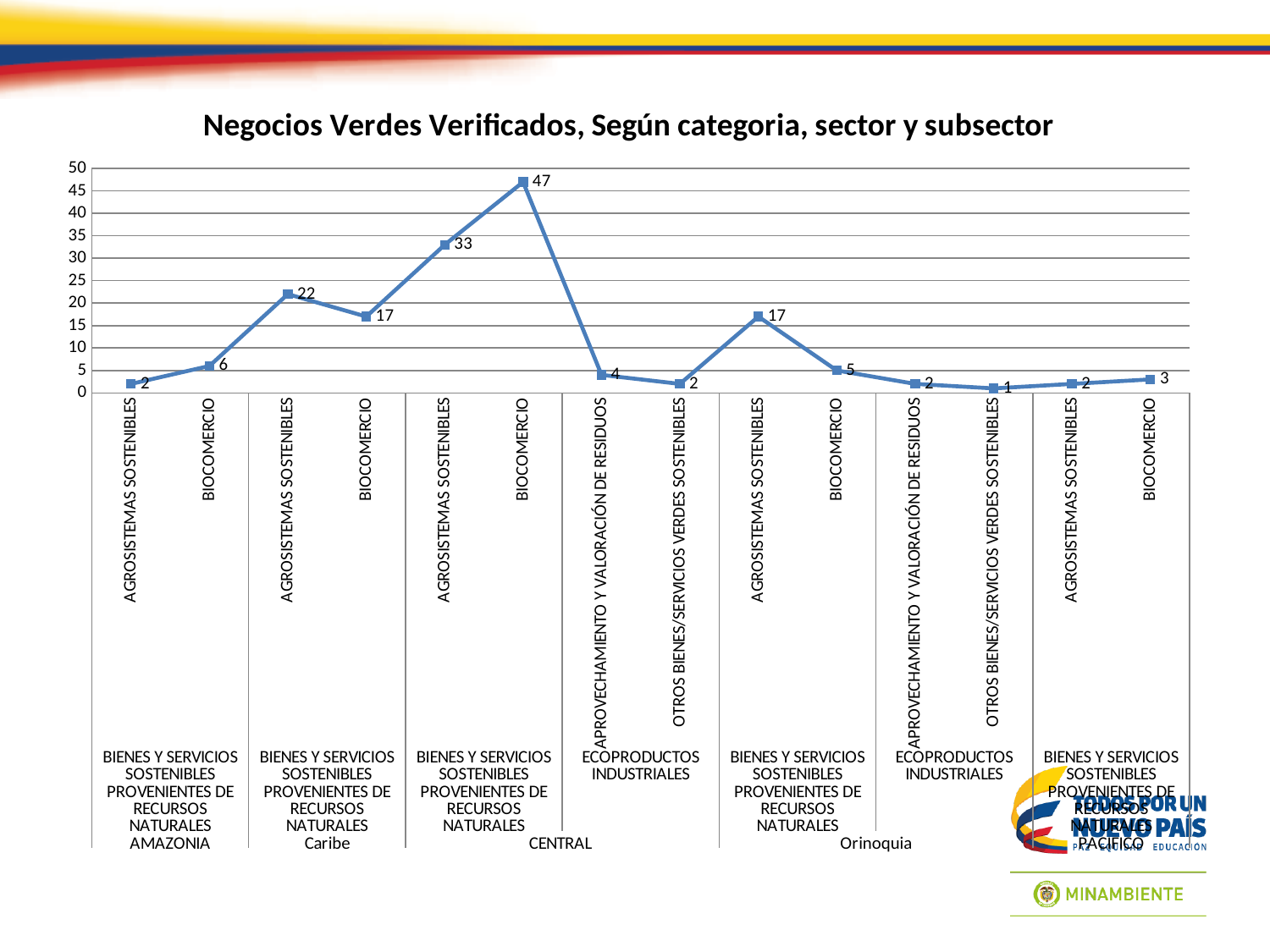
How many data points are plotted on the line? 14 Which data point has the highest value in the chart? BIOCOMERCIO (CENTRAL) What is the value for BIOCOMERCIO in the CENTRAL region? 47 Which is larger: AGROSISTEMAS SOSTENIBLES in Caribe or BIOCOMERCIO in Caribe? AGROSISTEMAS SOSTENIBLES in Caribe What is the title of the chart? Negocios Verdes Verificados, Según categoria, sector y subsector What is the value for APROVECHAMIENTO Y VALORACIÓN DE RESIDUOS in the CENTRAL region? 4 What is the value for BIOCOMERCIO in the AMAZONIA region? 6 What is the difference between the BIOCOMERCIO value in CENTRAL (47) and the AGROSISTEMAS SOSTENIBLES value in CENTRAL (33)? 14 What is the lowest value plotted in the chart? 1 What is the value for AGROSISTEMAS SOSTENIBLES in the Caribe region? 22 What is the value for AGROSISTEMAS SOSTENIBLES in the Orinoquia region? 17 What type of chart is shown on the slide? line chart